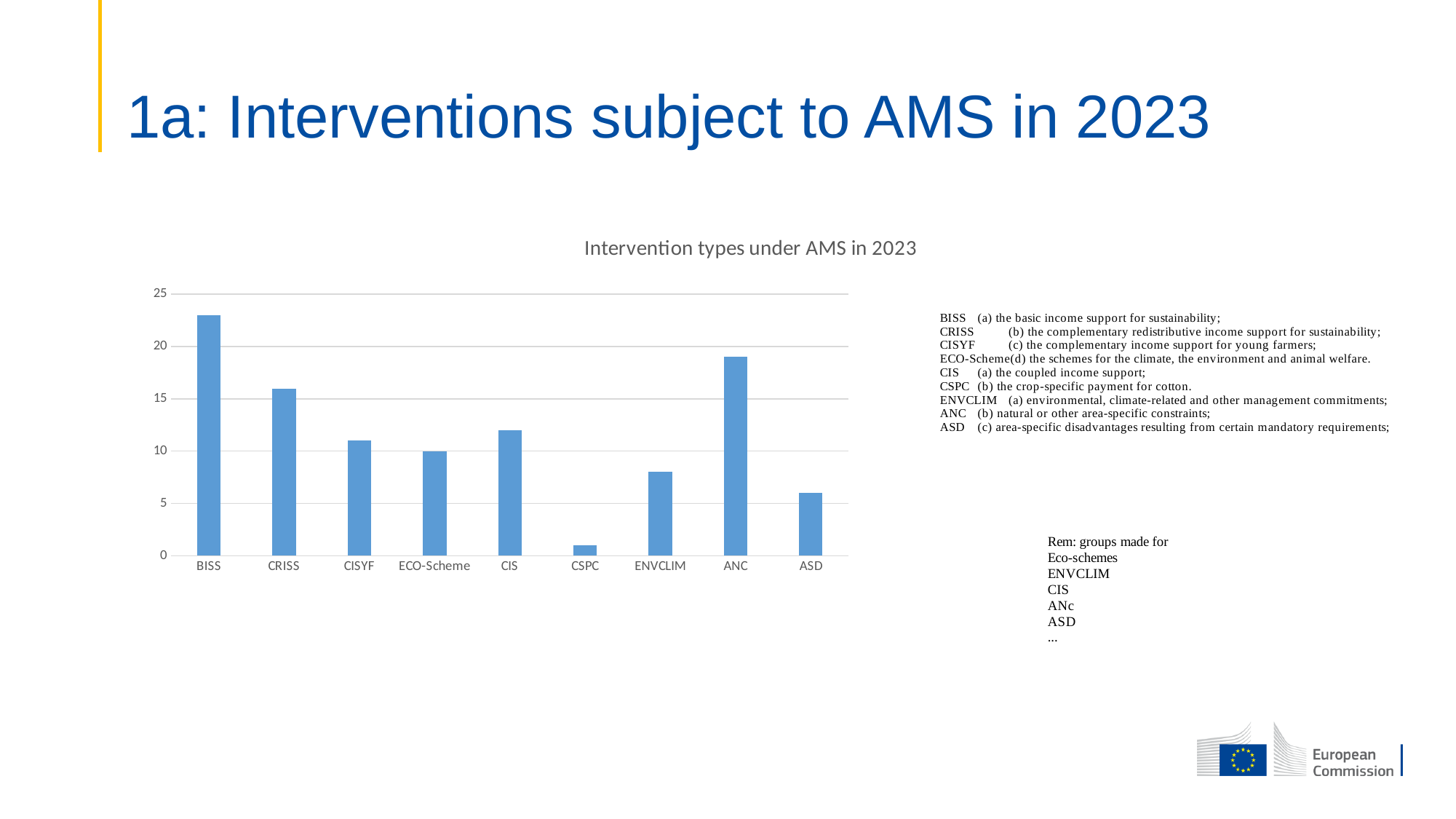
Is the value for ASD greater or less than 10? less Is the value for BISS greater or less than 20? greater Which has a larger value, ANC or CRISS? ANC Which intervention type has the highest value in the chart? BISS What is the title of the chart? Intervention types under AMS in 2023 Is the value for ENVCLIM greater or less than 10? less Which has a larger value, CIS or CISYF? CIS How many intervention types are shown on the x axis of the chart? 9 What type of chart is shown on the slide? bar chart Which intervention type has the lowest value in the chart? CSPC